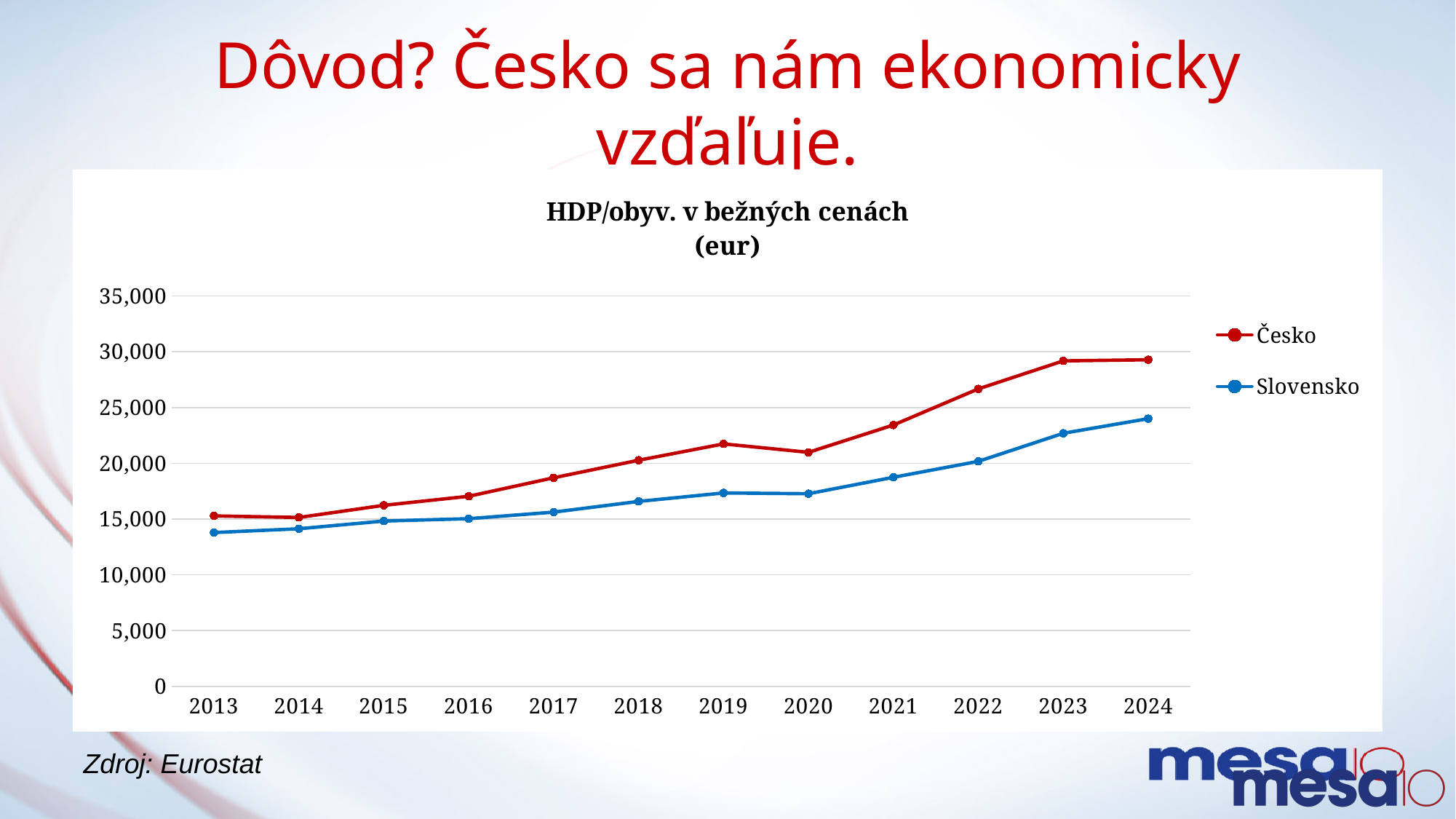
Is the value for Česko in 2019 greater or less than 20,000? greater Do the values for Slovensko generally rise or fall from 2013 to 2024? rise Is the value for Slovensko in 2013 greater or less than 15,000? less How many series does the legend list? 2 Which series has the higher value in 2024, Česko or Slovensko? Česko What kind of chart is shown on the slide? line chart In which year is the value for Slovensko highest? 2024 How many years are plotted along the x axis? 12 Is the value for Slovensko in 2021 greater or less than 20,000? less In which year is the value for Slovensko lowest? 2013 What is the title of the chart? HDP/obyv. v bežných cenách (eur)